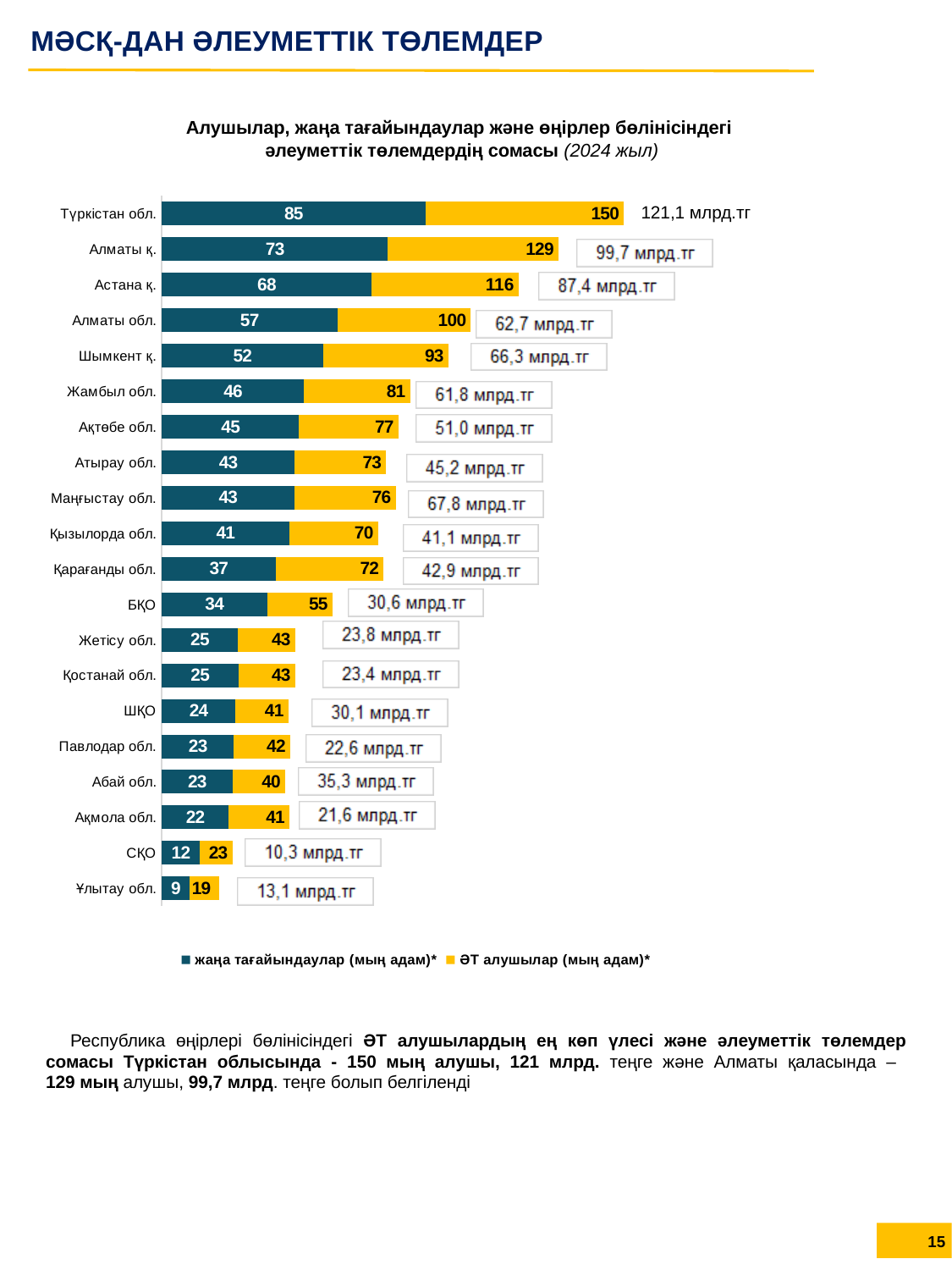
Which region has the highest value of 'ӘТ алушылар (мың адам)'? Түркістан обл. Which region has the lowest value of 'жаңа тағайындаулар (мың адам)'? Ұлытау обл. How many series does the chart legend list? 2 What colour represents the 'ӘТ алушылар (мың адам)' series in the chart? yellow What is the value of 'ӘТ алушылар (мың адам)' for СҚО? 23 What is the value of 'жаңа тағайындаулар (мың адам)' for Түркістан обл.? 85 What is the value of 'ӘТ алушылар (мың адам)' for Алматы қ.? 129 What kind of chart is shown on the slide? bar chart What amount in млрд.тг is shown next to the bar for Астана қ.? 87,4 млрд.тг How many regions are shown on the chart? 20 What is the difference between the 'ӘТ алушылар (мың адам)' values for Түркістан обл. and Алматы қ.? 21 Which region has a larger 'жаңа тағайындаулар (мың адам)' value, Шымкент қ. or Жамбыл обл.? Шымкент қ.